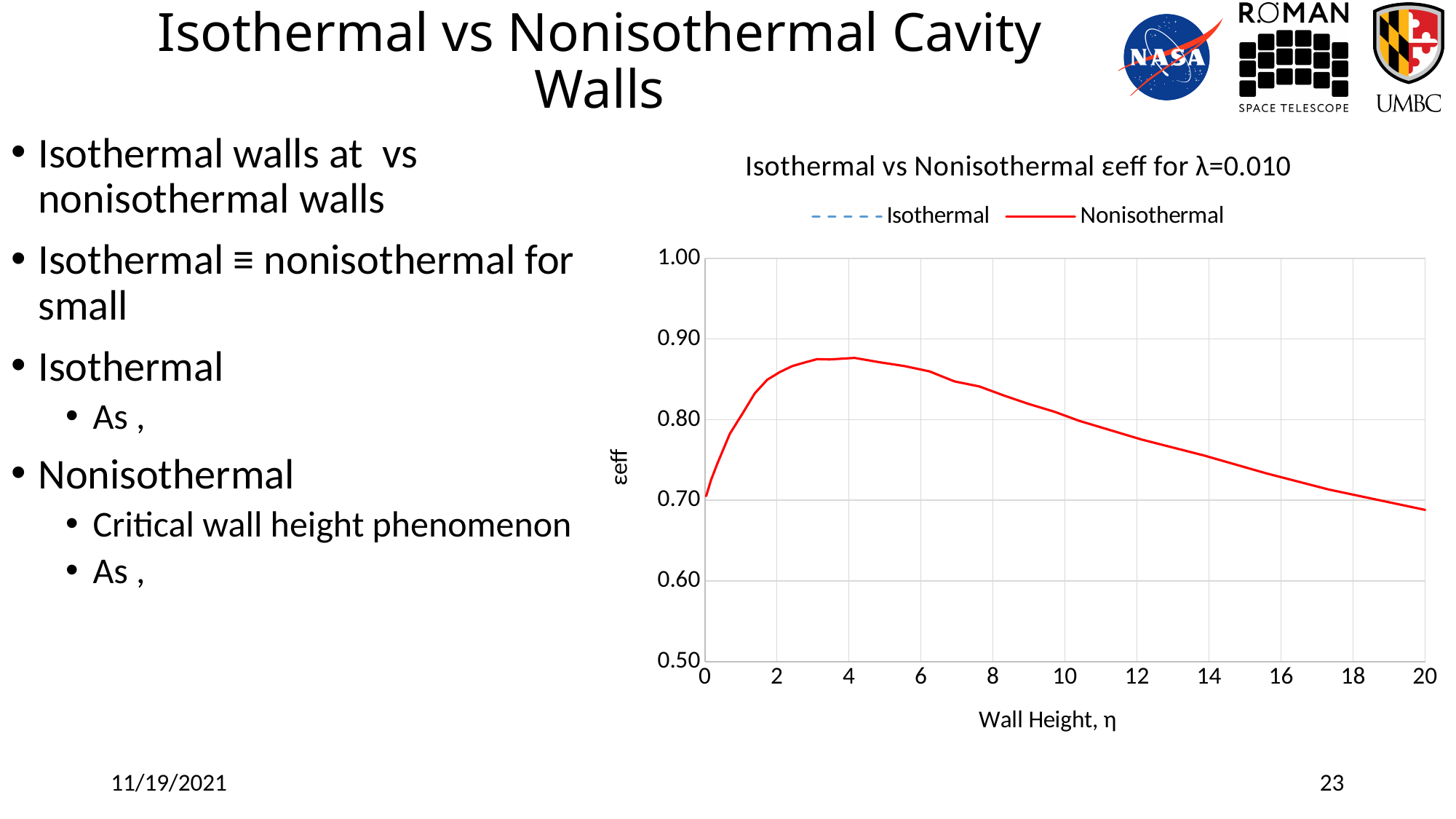
Is the Nonisothermal value at wall height 4 greater or less than 0.80? greater Is the Nonisothermal value at wall height 2 greater or less than 0.80? greater Is the Nonisothermal value at wall height 14 greater or less than 0.80? less How many series does the legend of the chart list? 2 Does the Nonisothermal curve rise or fall as wall height increases from 4 to 20? fall What kind of chart is shown on the slide? line chart What is the label of the x axis of the chart? Wall Height, η What is the title of the chart? Isothermal vs Nonisothermal εeff for λ=0.010 Does the Nonisothermal curve rise or fall as wall height increases from 0 to 2? rise